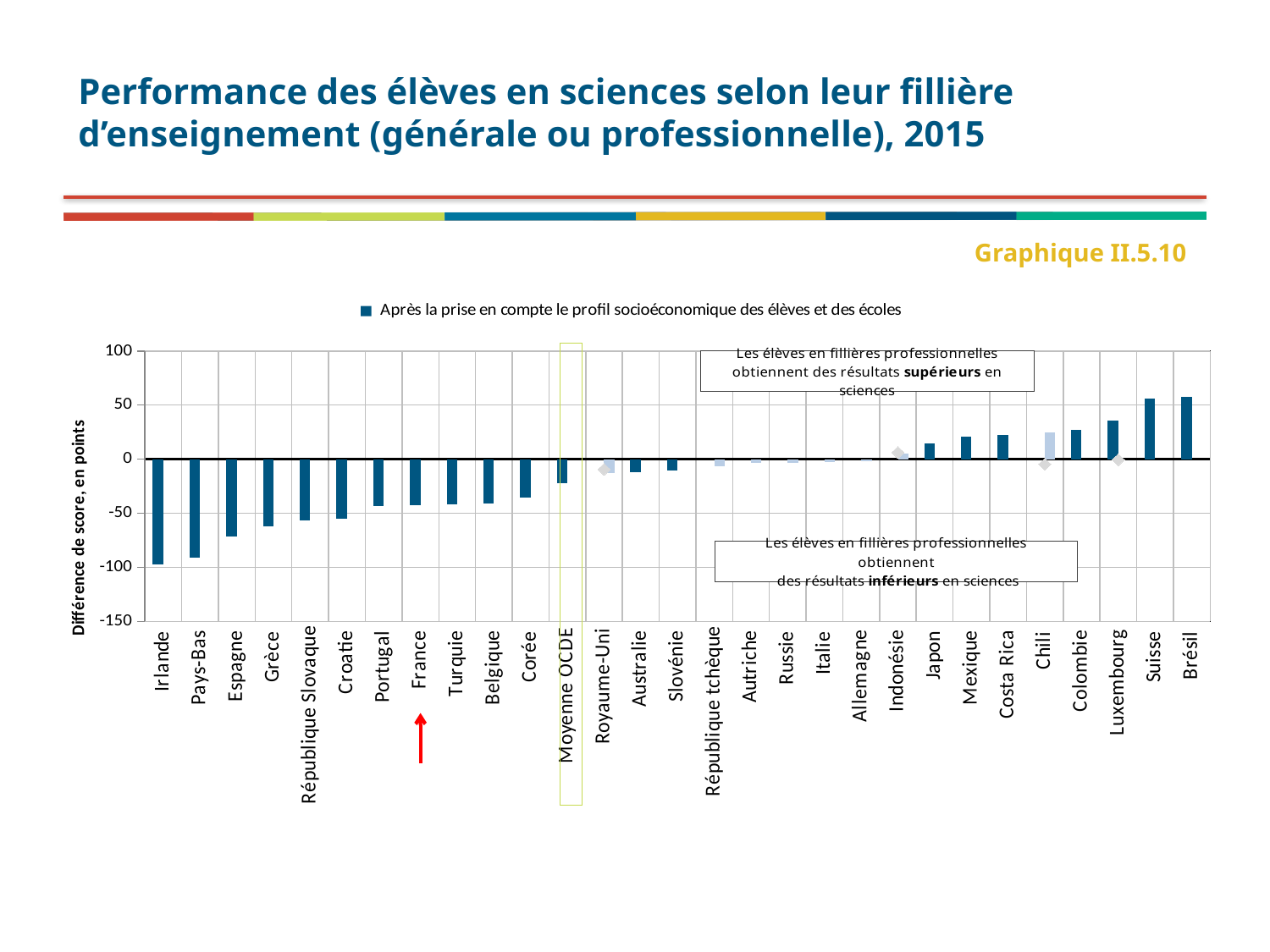
What is the title of the vertical axis of the chart? Différence de score, en points How many series does the chart legend list? 1 Is the value for Brésil greater or less than 50? greater Is the value for Luxembourg greater or less than 50? less Which has the larger value, Suisse or Luxembourg? Suisse Do the values generally rise or fall moving from left to right along the x axis? rise Which has the larger value, Espagne or Grèce? Grèce Is the value for France greater or less than -50? greater Which category has the lowest value in the chart? Irlande How many categories are plotted along the x axis of the chart? 29 What kind of chart is shown on the slide? bar chart